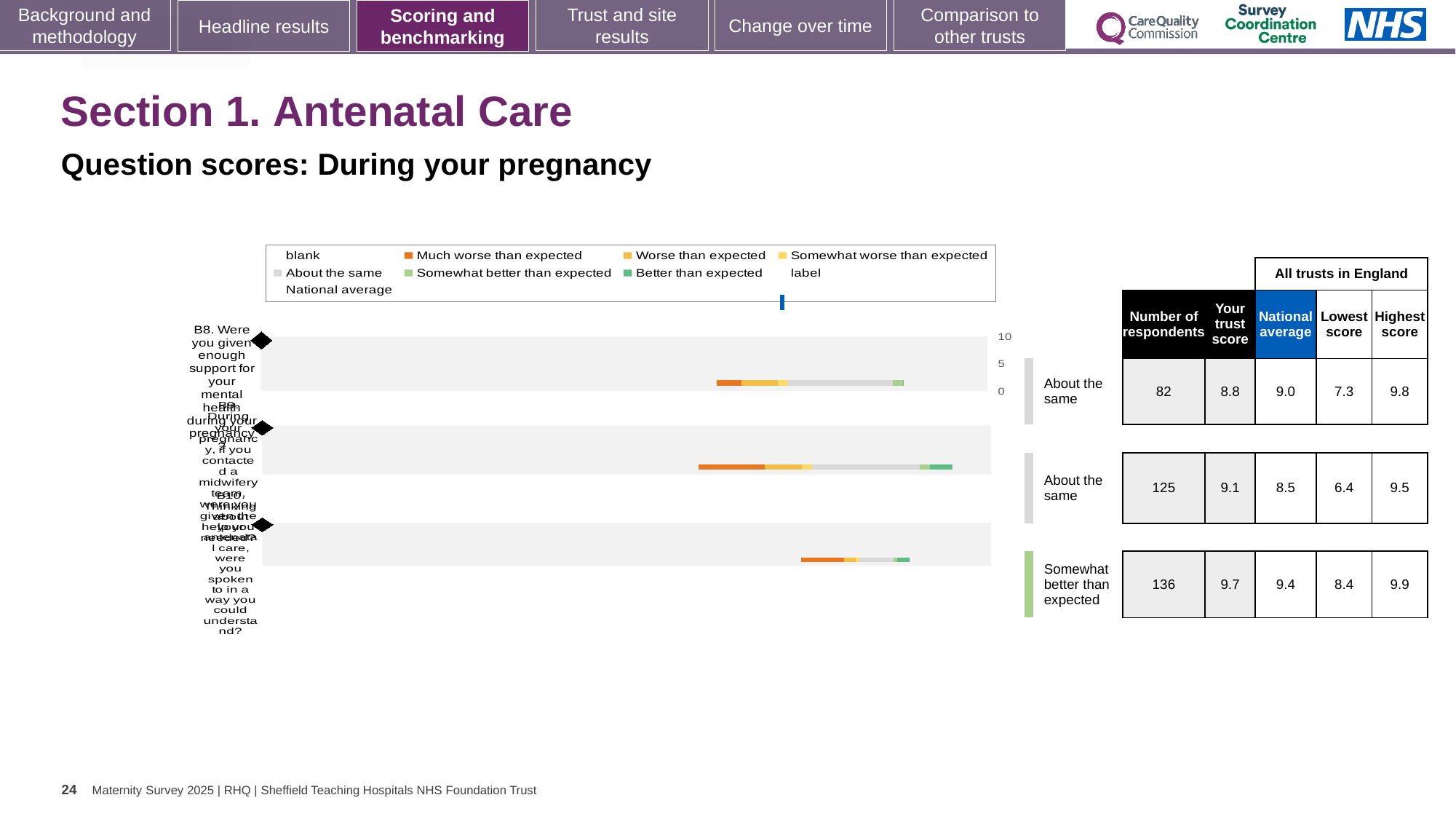
In the table beside the chart, for the first row (question B8), which is larger: the trust score or the national average? the national average (9.0) What benchmark category is shown for the third row of the chart? Somewhat better than expected How many question rows (bars) does the chart show? 3 How many entries does the chart's legend list? 9 What kind of chart is shown on the slide? bar chart In the table beside the chart, what is the lowest score for the second row? 6.4 In the table beside the chart, what is the difference between the trust score and the national average for the second row? 0.6 What colour does the legend use for 'Much worse than expected'? orange What is the highest tick value shown on the chart's axis? 10 In the table beside the chart, what is the trust score for the third row? 9.7 In the table beside the chart, what is the number of respondents for the first row (question B8)? 82 In the table beside the chart, which row has the highest trust score? the third row (9.7)